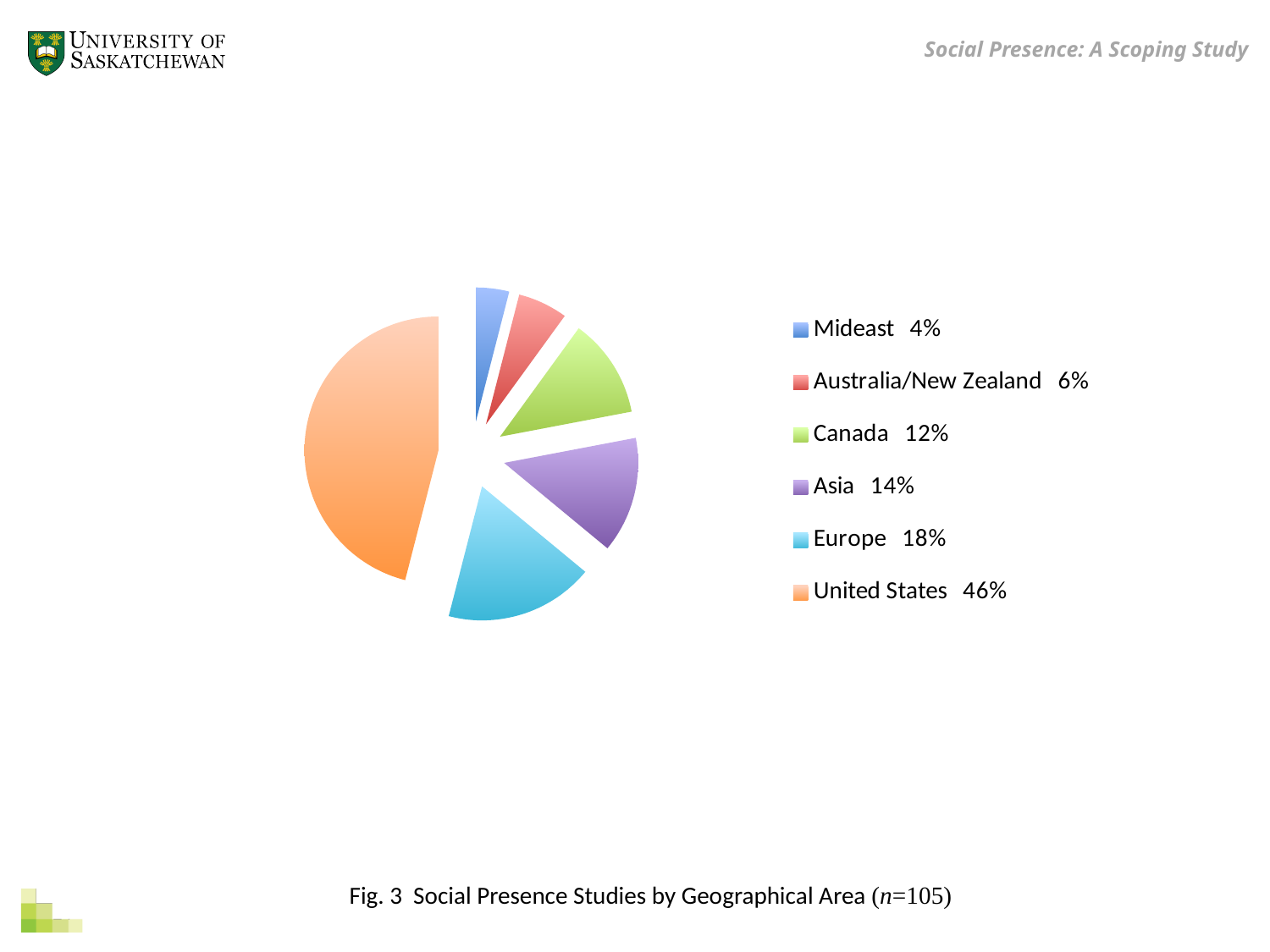
Which has a larger share, Asia or Canada? Asia What kind of chart is shown on the slide? pie chart How many geographical areas are shown in the pie chart? 6 What percentage of studies is from Australia/New Zealand? 6% What share of social presence studies is from the United States? 46% What percentage of studies is from Asia? 14% What is the difference in percentage points between the United States and Europe? 28 Which geographical area has the largest share of studies? United States Which geographical area has the smallest share of studies? Mideast What percentage of studies is from Europe? 18% What percentage of studies is from Canada? 12% What is the total number of studies (n) given in the figure caption? 105